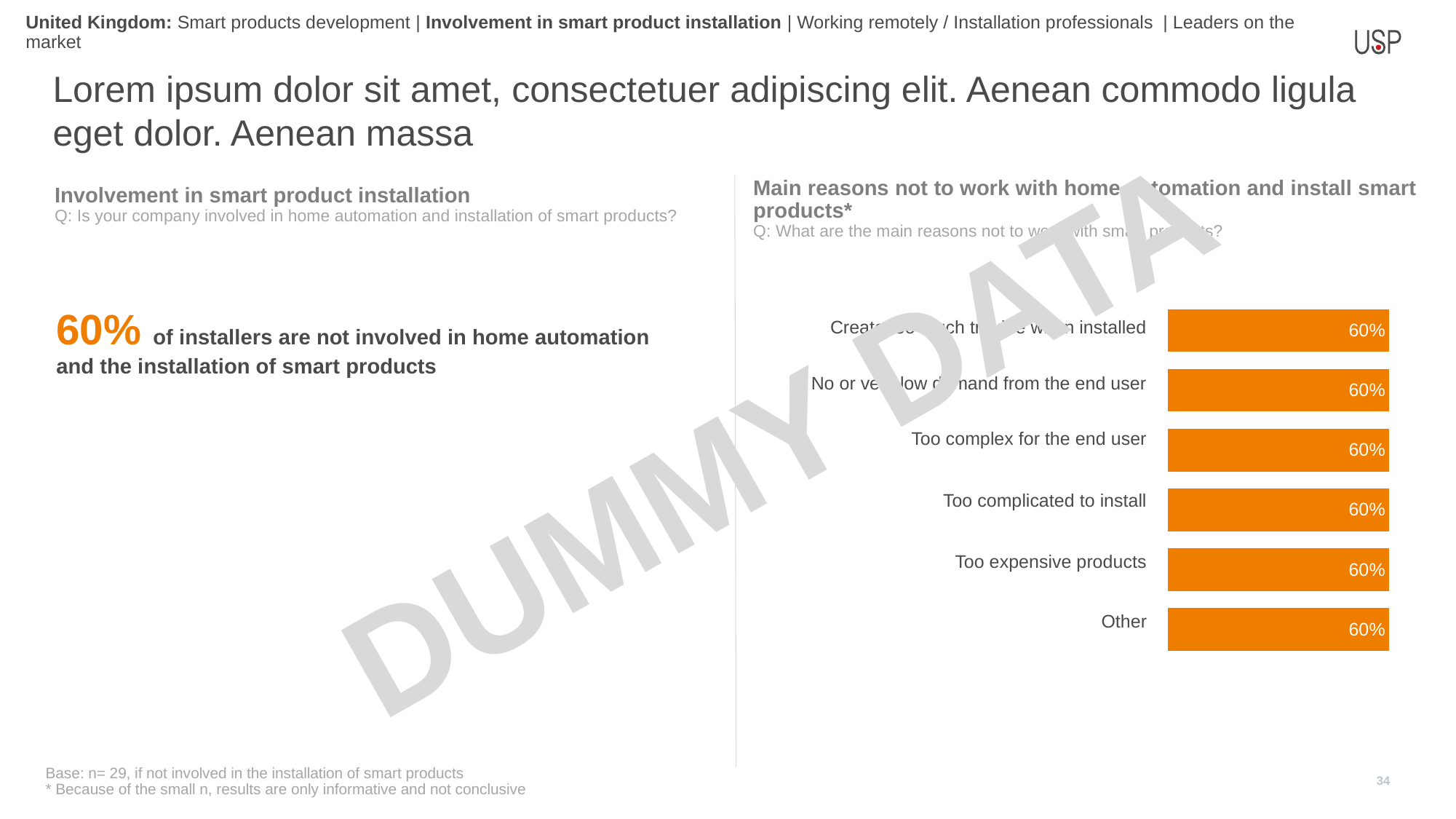
In the chart 'Main reasons not to work with home automation and install smart products', what is the value for 'Too complicated to install'? 60% What colour are the bars in the chart 'Main reasons not to work with home automation and install smart products'? Orange In the chart 'Main reasons not to work with home automation and install smart products', what is the value for 'Too expensive products'? 60% In the chart 'Main reasons not to work with home automation and install smart products', what is the value for 'Too complex for the end user'? 60% In the chart 'Main reasons not to work with home automation and install smart products', do all the bars show the same value? Yes In the chart 'Main reasons not to work with home automation and install smart products', is the value for 'Too expensive products' larger than the value for 'Other', or are they equal? They are equal In the chart 'Main reasons not to work with home automation and install smart products', what is the value for 'Other'? 60% What kind of chart is used for 'Main reasons not to work with home automation and install smart products'? Bar chart In the chart 'Main reasons not to work with home automation and install smart products', what is the difference between the values for 'Too complex for the end user' and 'Too complicated to install'? 0% Which category is listed at the bottom of the chart 'Main reasons not to work with home automation and install smart products'? Other How many categories (bars) are shown in the chart 'Main reasons not to work with home automation and install smart products'? 6